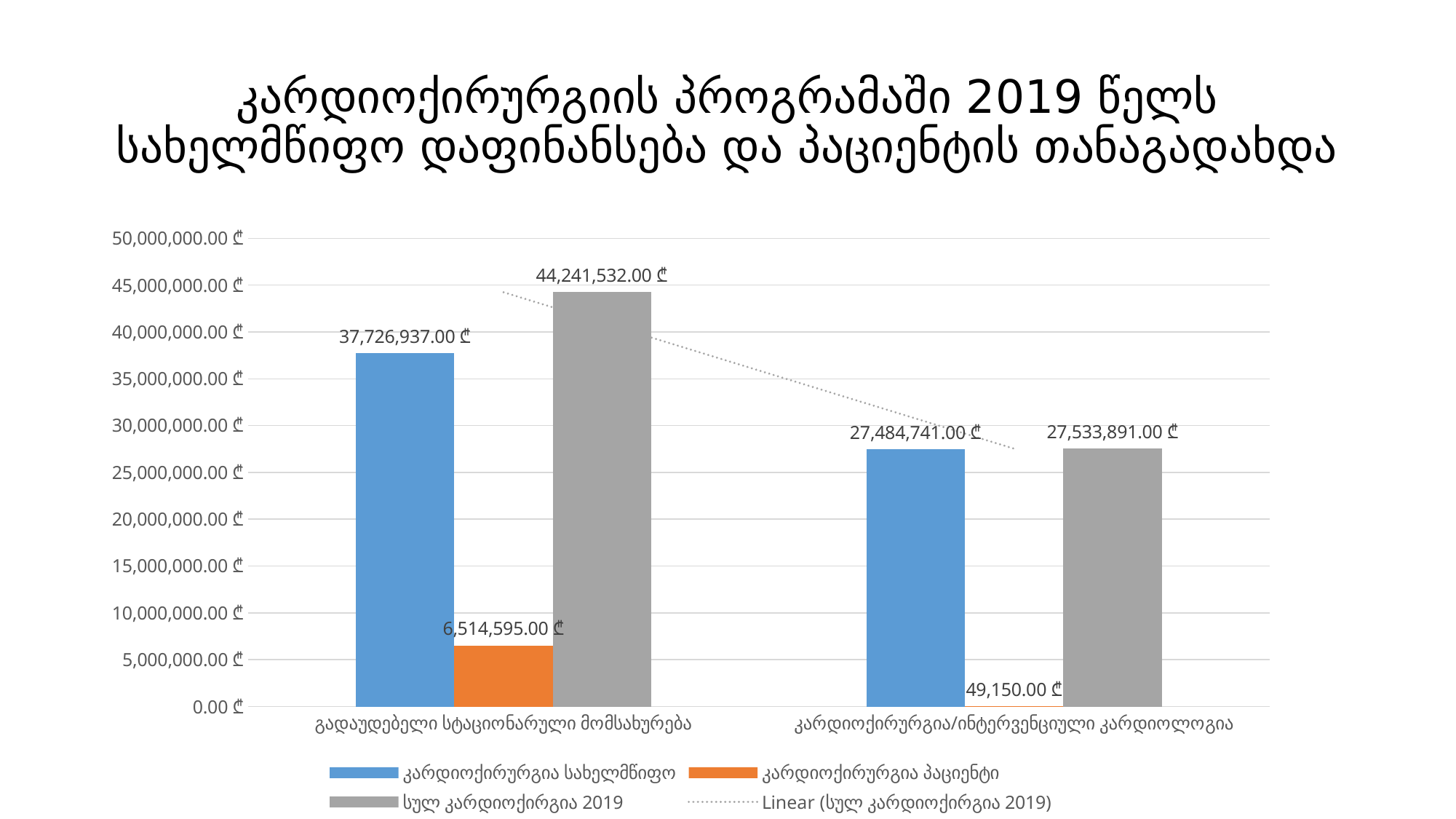
Which bar has the highest value on the chart? სულ კარდიოქირურგია 2019 for გადაუდებელი სტაციონარული მომსახურება (44,241,532.00 ₾) What is the value of სულ კარდიოქირურგია 2019 for კარდიოქირურგია/ინტერვენციული კარდიოლოგია? 27,533,891.00 ₾ Which is larger: კარდიოქირურგია სახელმწიფო for გადაუდებელი სტაციონარული მომსახურება or for კარდიოქირურგია/ინტერვენციული კარდიოლოგია? გადაუდებელი სტაციონარული მომსახურება What type of chart is shown on the slide? bar chart What is the value of კარდიოქირურგია სახელმწიფო for გადაუდებელი სტაციონარული მომსახურება? 37,726,937.00 ₾ How many categories are shown on the x axis? 2 What is the difference between კარდიოქირურგია სახელმწიფო for გადაუდებელი სტაციონარული მომსახურება and for კარდიოქირურგია/ინტერვენციული კარდიოლოგია? 10,242,196.00 ₾ What is the difference between სულ კარდიოქირურგია 2019 for გადაუდებელი სტაციონარული მომსახურება and for კარდიოქირურგია/ინტერვენციული კარდიოლოგია? 16,707,641.00 ₾ What is the value of კარდიოქირურგია პაციენტი for კარდიოქირურგია/ინტერვენციული კარდიოლოგია? 49,150.00 ₾ How many entries does the legend list? 4 What is the value of კარდიოქირურგია პაციენტი for გადაუდებელი სტაციონარული მომსახურება? 6,514,595.00 ₾ Which bar has the lowest value on the chart? კარდიოქირურგია პაციენტი for კარდიოქირურგია/ინტერვენციული კარდიოლოგია (49,150.00 ₾)